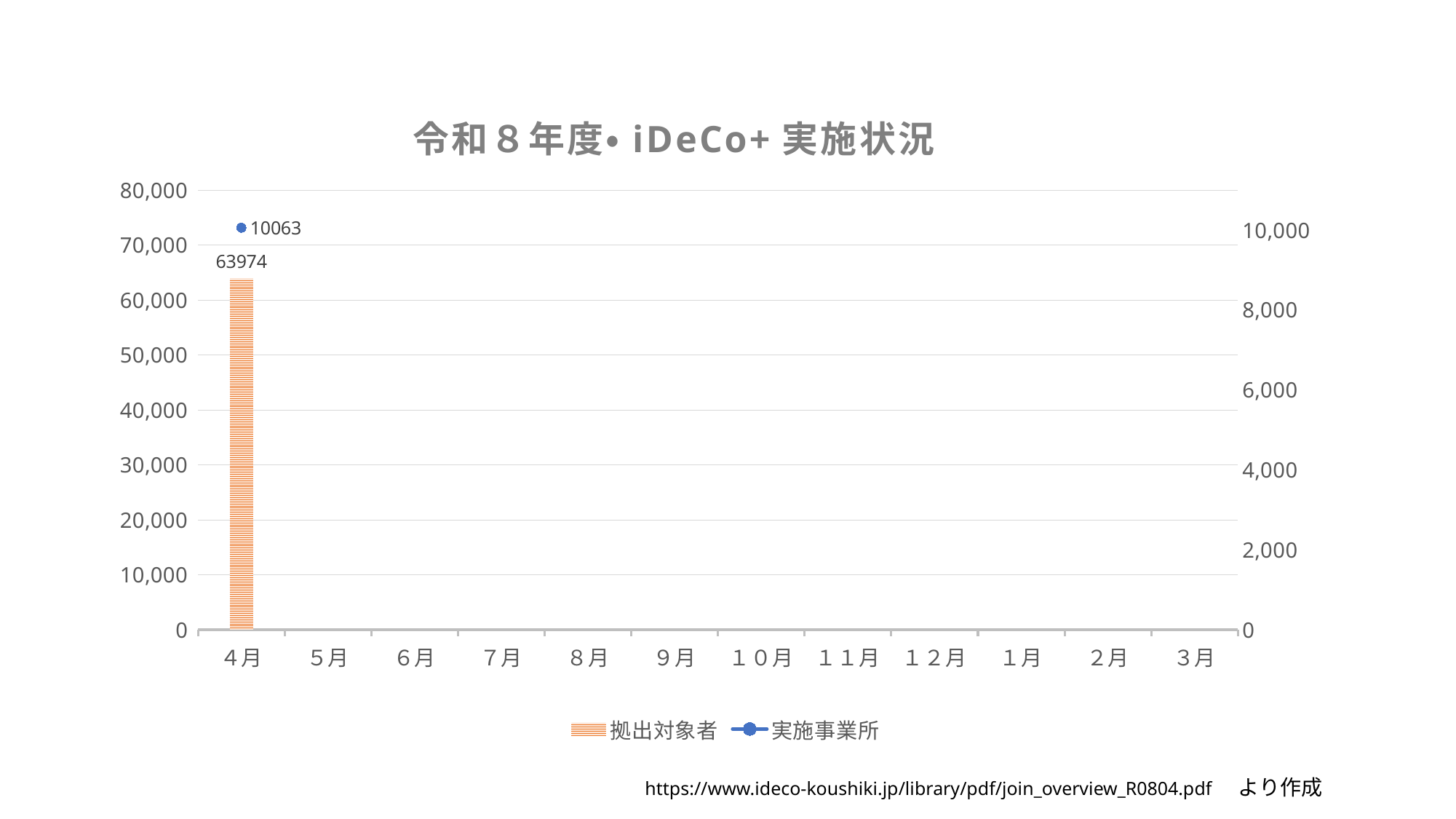
What is the highest tick value shown on the right vertical axis? 10,000 Which month is the only one with plotted data? 4月 Is the 実施事業所 value for 4月 greater or less than 8,000 on the right axis? greater What is the value of 拠出対象者 for 4月? 63974 What is the value of 実施事業所 for 4月? 10063 How many series does the legend list? 2 What is the title of the chart? 令和８年度• iDeCo+ 実施状況 How many month categories are shown on the x axis? 12 Is the 拠出対象者 value for 4月 greater or less than 60,000 on the left axis? greater